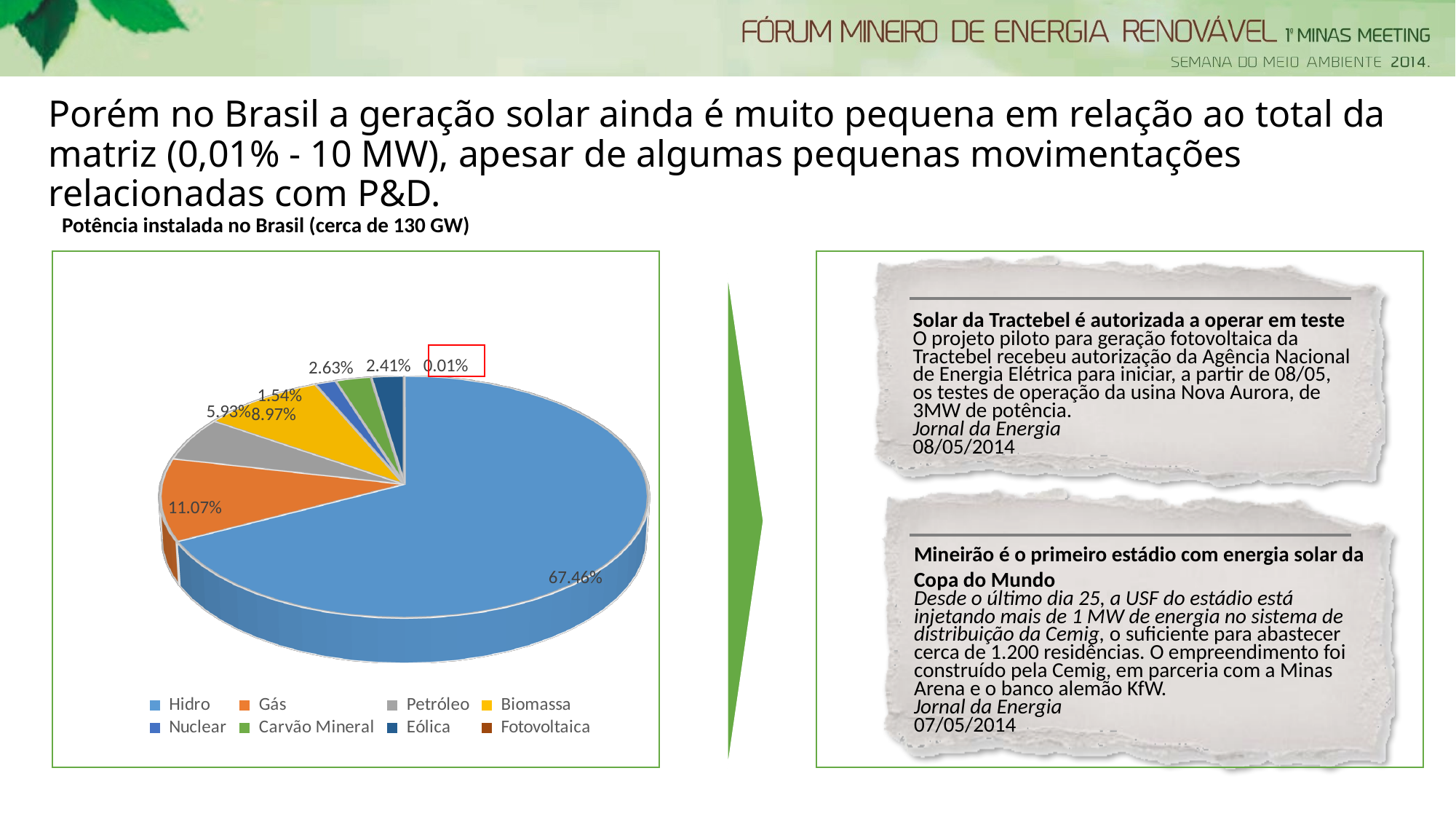
What is the value shown for Biomassa? 8.97% What share of the pie does Hidro represent? 67.46% What is the value shown for Fotovoltaica? 0.01% Which category has the smallest slice of the pie? Fotovoltaica What is the difference between the Gás and Biomassa shares? 2.10% What is the title given above the pie chart? Potência instalada no Brasil (cerca de 130 GW) Which is larger, the share for Gás or the share for Petróleo? Gás Which category has the largest slice of the pie? Hidro How many categories does the pie chart show? 8 What kind of chart is shown on the slide? pie chart What is the value shown for Petróleo? 5.93% What is the value shown for Gás? 11.07%